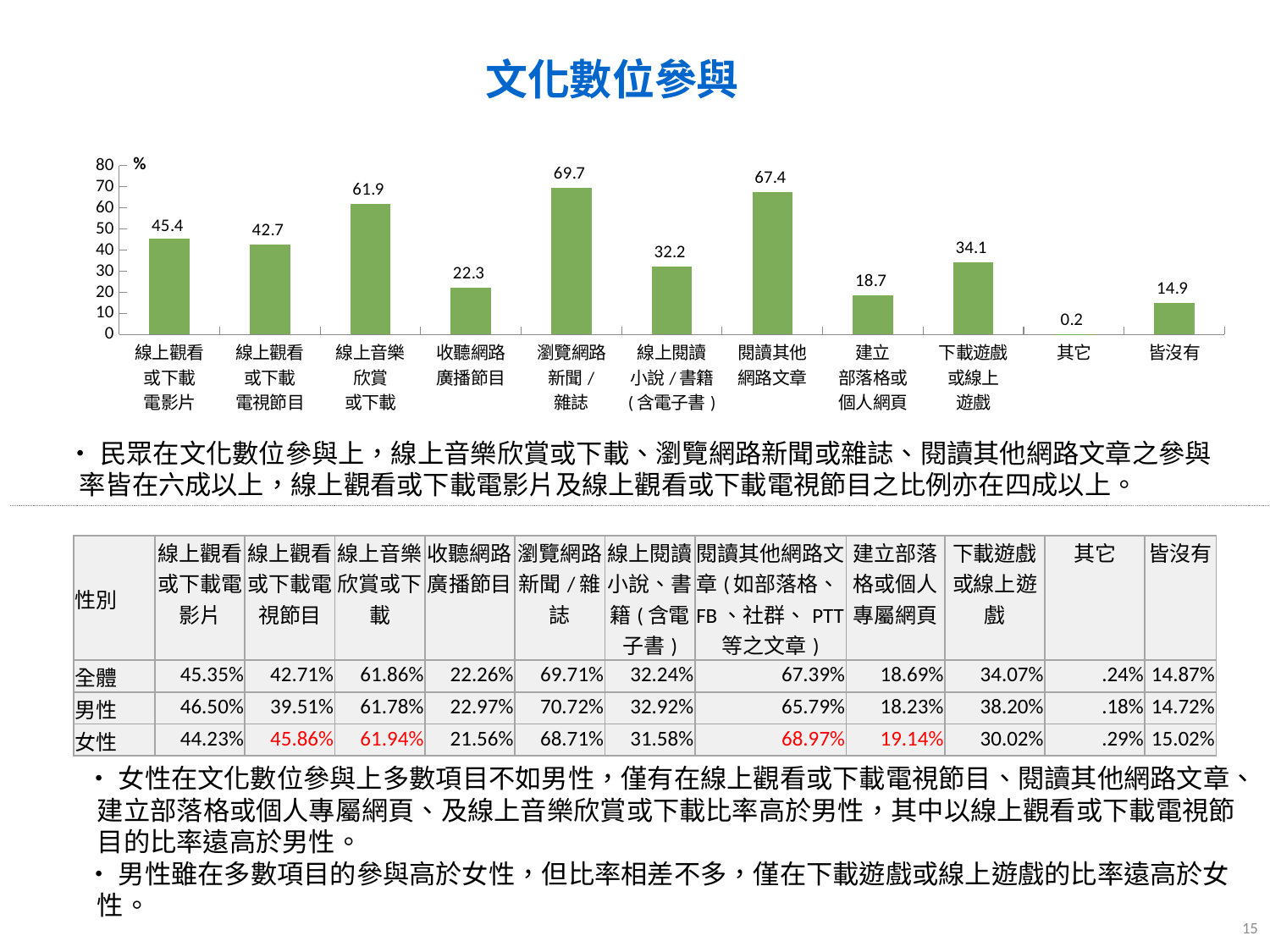
What kind of chart is shown on the slide? bar chart What is the value for 瀏覽網路新聞／雜誌 in the bar chart? 69.7 What is the value for 下載遊戲或線上遊戲 in the bar chart? 34.1 How many categories are shown in the bar chart? 11 Which category has the highest value in the bar chart? 瀏覽網路新聞／雜誌 Is the value for 線上閱讀小說／書籍（含電子書） greater or less than 30 in the bar chart? greater What is the title of the slide containing the chart? 文化數位參與 Which category has the lowest value in the bar chart? 其它 Which is larger in the bar chart: 線上音樂欣賞或下載 or 閱讀其他網路文章? 閱讀其他網路文章 What is the value for 收聽網路廣播節目 in the bar chart? 22.3 What is the difference between the values for 線上觀看或下載電影片 and 線上觀看或下載電視節目 in the bar chart? 2.7 What unit is indicated at the top of the vertical axis of the bar chart? %